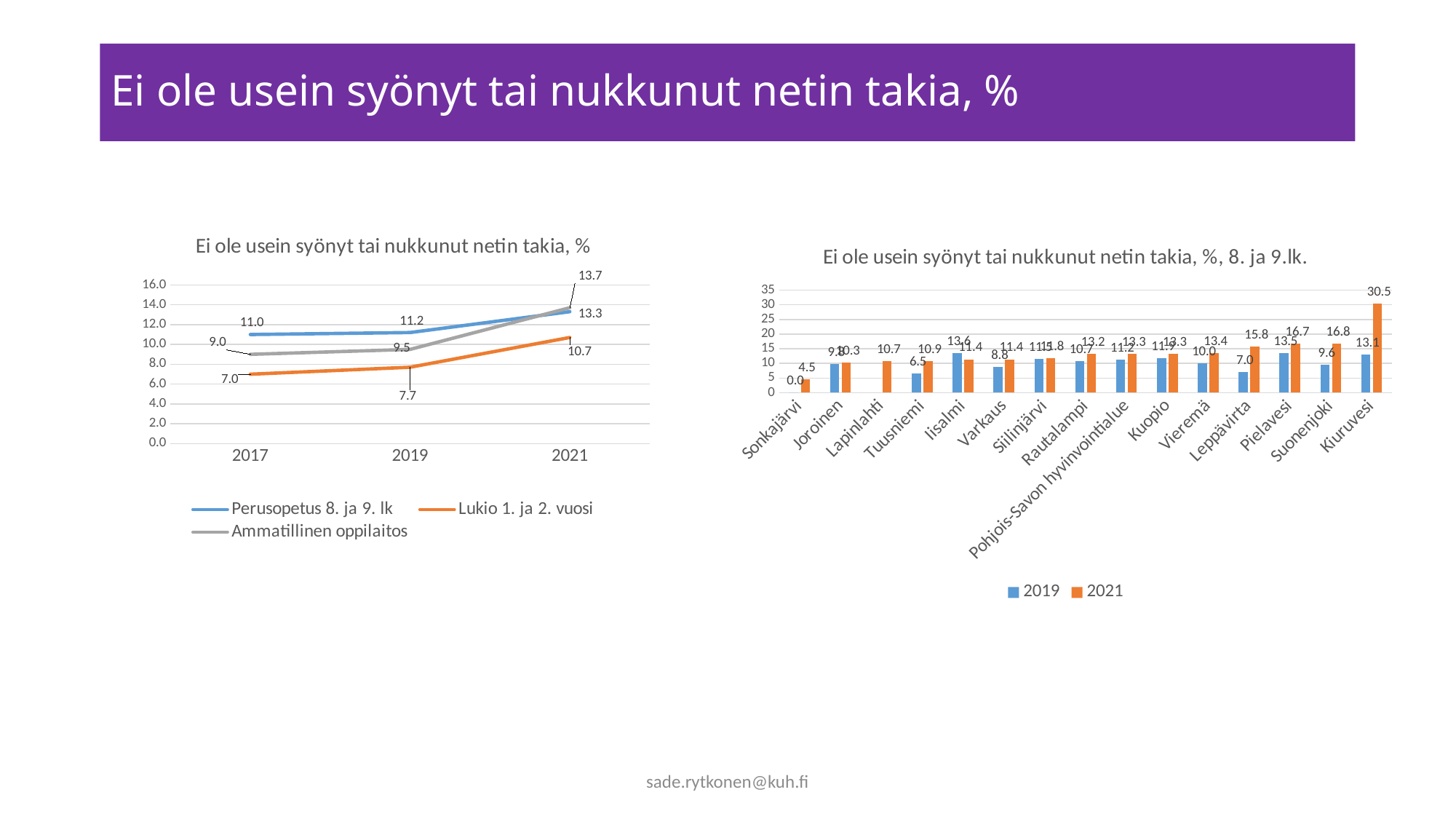
On the right chart, what is the 2021 value for Kiuruvesi? 30.5 On the right chart, how many categories are shown on the x axis? 15 On the right chart, which municipality has the highest 2021 value? Kiuruvesi On the left chart, by how much did the Perusopetus 8. ja 9. lk value increase from 2017 to 2021? 2.3 On the left chart, what is the value for Ammatillinen oppilaitos in 2021? 13.7 On the left chart, what is the value for Lukio 1. ja 2. vuosi in 2017? 7.0 On the left chart, does the Lukio 1. ja 2. vuosi series rise or fall from 2017 to 2021? rise On the right chart, what is the 2019 value for Tuusniemi? 6.5 What kind of chart is the left chart? line chart On the left chart, how many series does the legend list? 3 On the left chart, which series has the highest value in 2021? Ammatillinen oppilaitos On the right chart, which is larger for Leppävirta: the 2019 value or the 2021 value? 2021